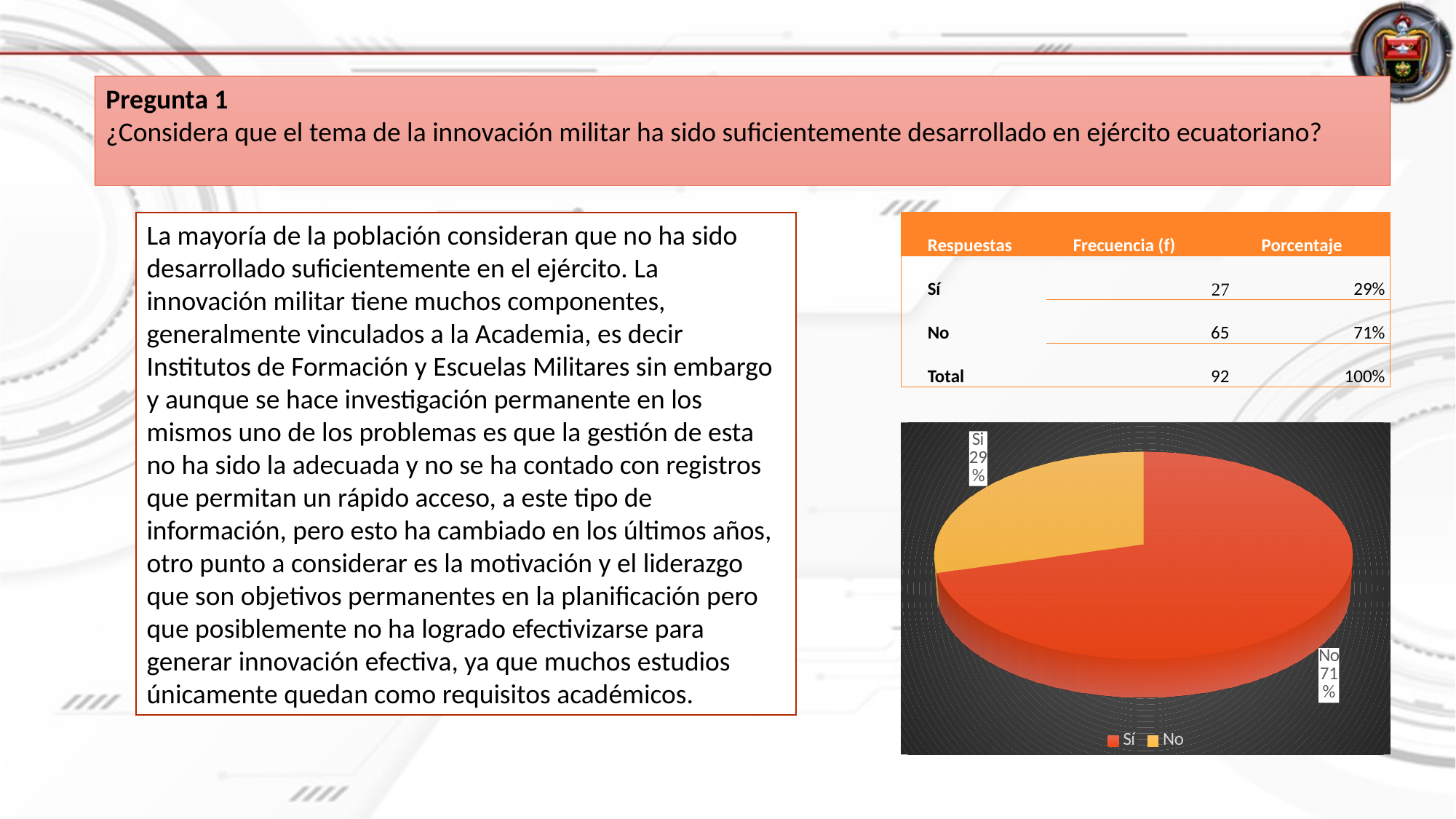
Which is larger in the pie chart, the "Si" slice or the "No" slice? No Which slice of the pie chart is the largest? No What share of the pie chart is labelled "Si"? 29% What kind of chart is shown on the slide? pie chart What are the two entries listed in the pie chart's legend? Sí and No How many entries does the pie chart's legend list? 2 Which slice of the pie chart is the smallest? Si What share of the pie chart is labelled "No"? 71% What is the difference in percentage points between the "No" slice and the "Si" slice in the pie chart? 42 Is the share of the "No" slice in the pie chart greater or less than 50%? greater How many slices does the pie chart have? 2